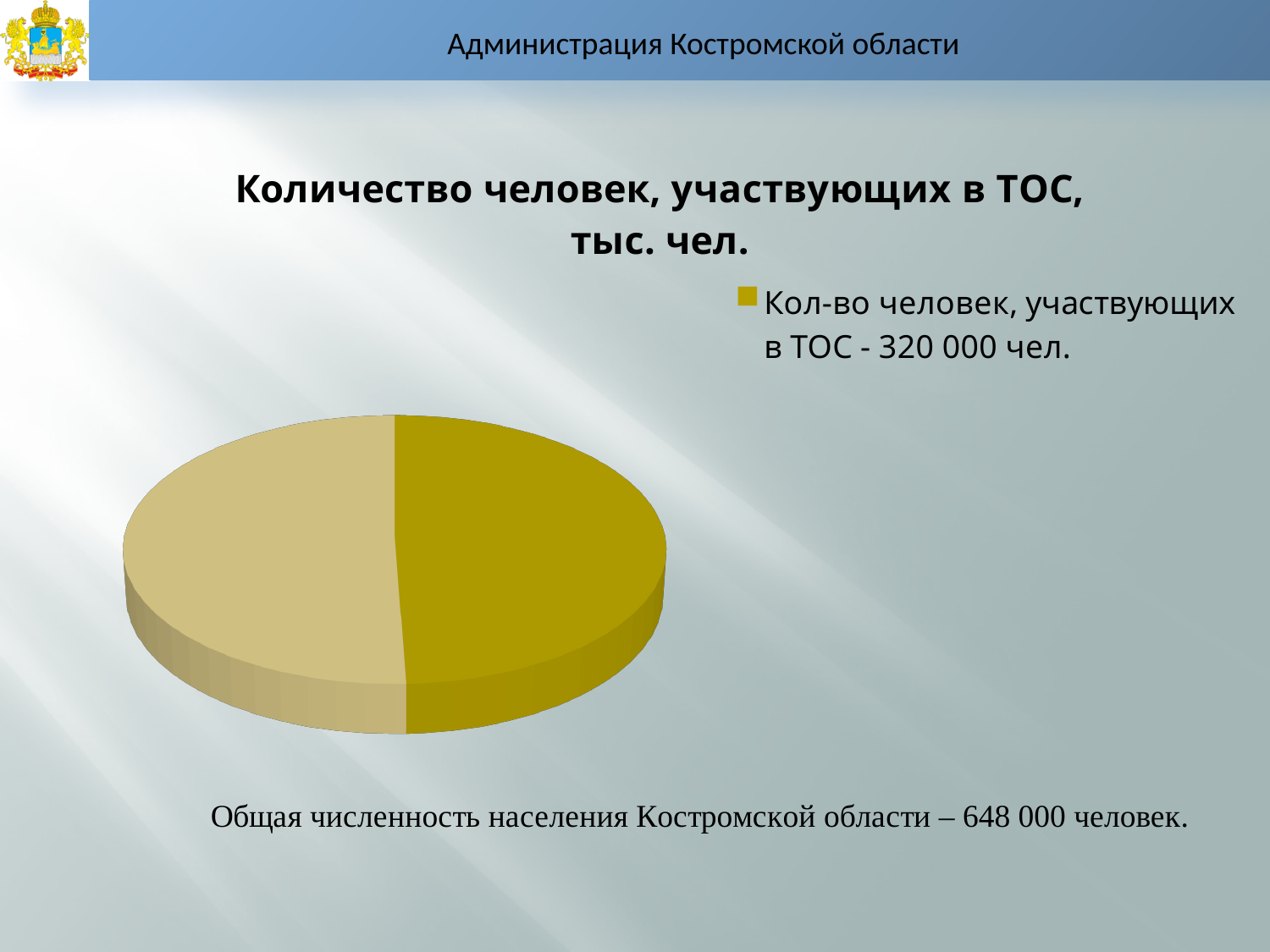
What kind of chart is shown on the slide? pie chart What is the legend entry text for the darker slice of the pie chart? Кол-во человек, участвующих в ТОС - 320 000 чел. How many entries does the chart legend list? 1 What is the title of the chart? Количество человек, участвующих в ТОС, тыс. чел. How many slices does the pie chart have? 2 According to the legend, how many people participate in ТОС? 320 000 чел. According to the text below the chart, what is the total population of Костромская область? 648 000 человек